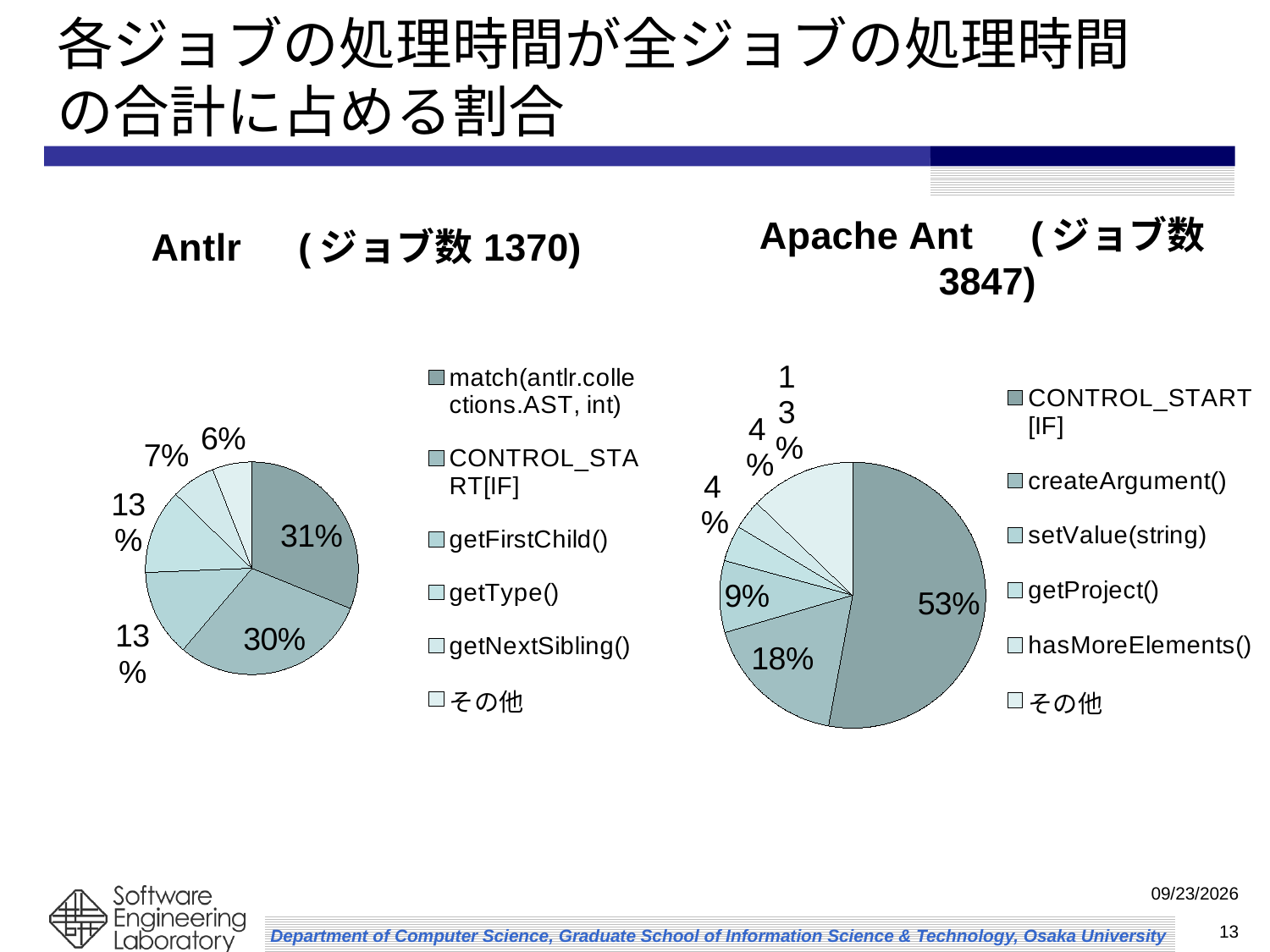
In the Antlr pie chart, what share does getNextSibling() have? 7% How many slices does the Apache Ant pie chart have? 6 In the Antlr pie chart, what share does CONTROL_START[IF] have? 30% In the Antlr pie chart, which slice is the smallest? その他 In the Apache Ant pie chart, what share does setValue(string) have? 9% In the Apache Ant pie chart, which slice is the largest? CONTROL_START[IF] In the Antlr pie chart, which is larger: the share for getFirstChild() or the share for getNextSibling()? getFirstChild() In the Apache Ant pie chart, what share does CONTROL_START[IF] have? 53% What kind of chart is used for Antlr on this slide? Pie chart In the Apache Ant pie chart, what share does createArgument() have? 18% In the Antlr pie chart, what share does match(antlr.collections.AST, int) have? 31% In the Apache Ant pie chart, what is the difference between the CONTROL_START[IF] share and the createArgument() share? 35%